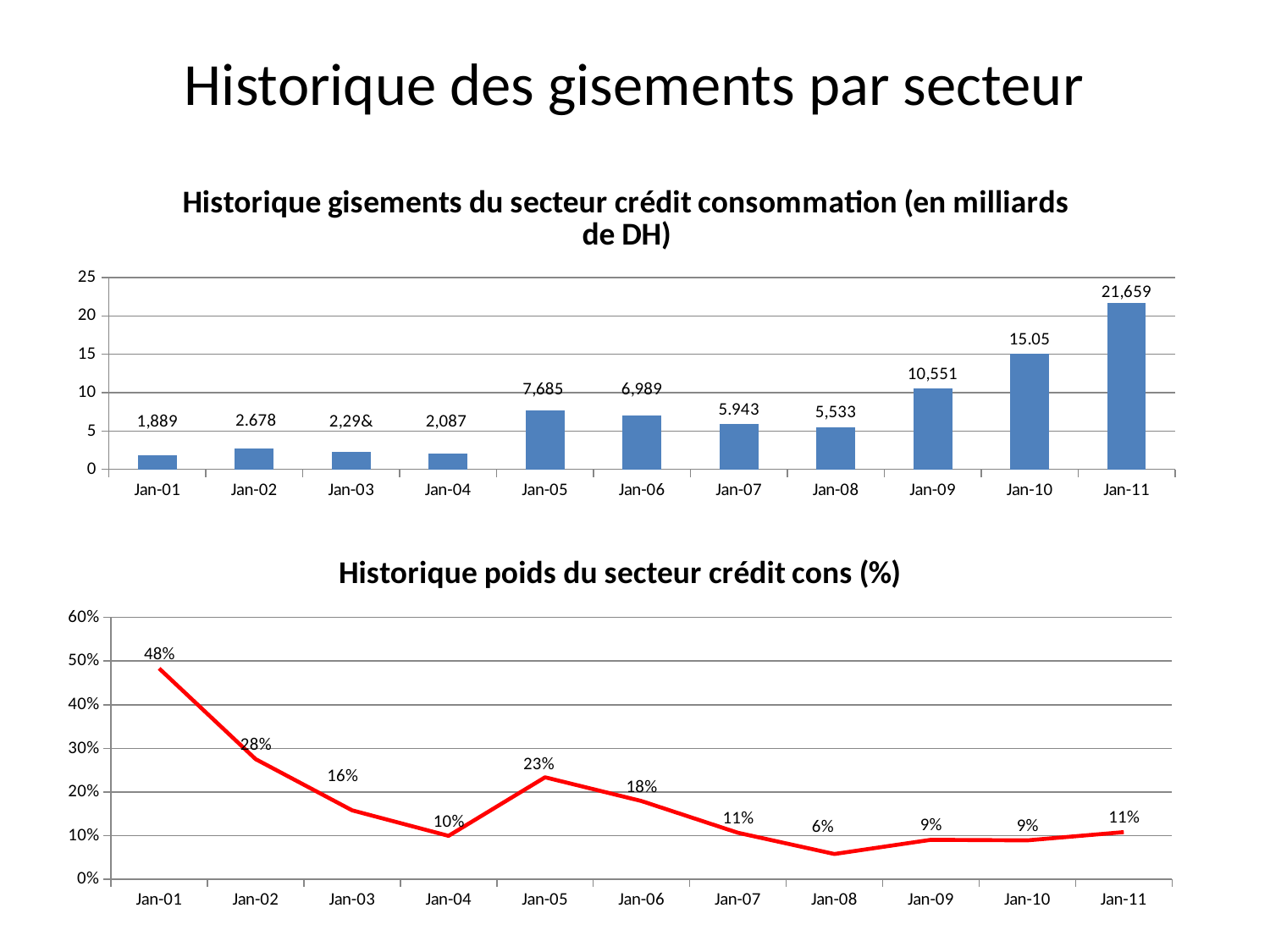
What kind of chart is the top chart? bar chart In the bottom chart, what is the value for Jan-05? 23% In the top chart, is the value for Jan-10 greater or less than 10? greater How many bars are in the top chart? 11 In the top chart, what is the value for Jan-11? 21,659 In the top chart, which year has the lowest value? Jan-01 In the top chart, what is the value for Jan-09? 10,551 In the bottom chart, what is the difference between the values for Jan-01 and Jan-02? 20% In the top chart, which year has the highest value? Jan-11 In the bottom chart, which year has the lowest value? Jan-08 In the top chart, which is larger, the value for Jan-05 or the value for Jan-08? Jan-05 What kind of chart is the bottom chart? line chart